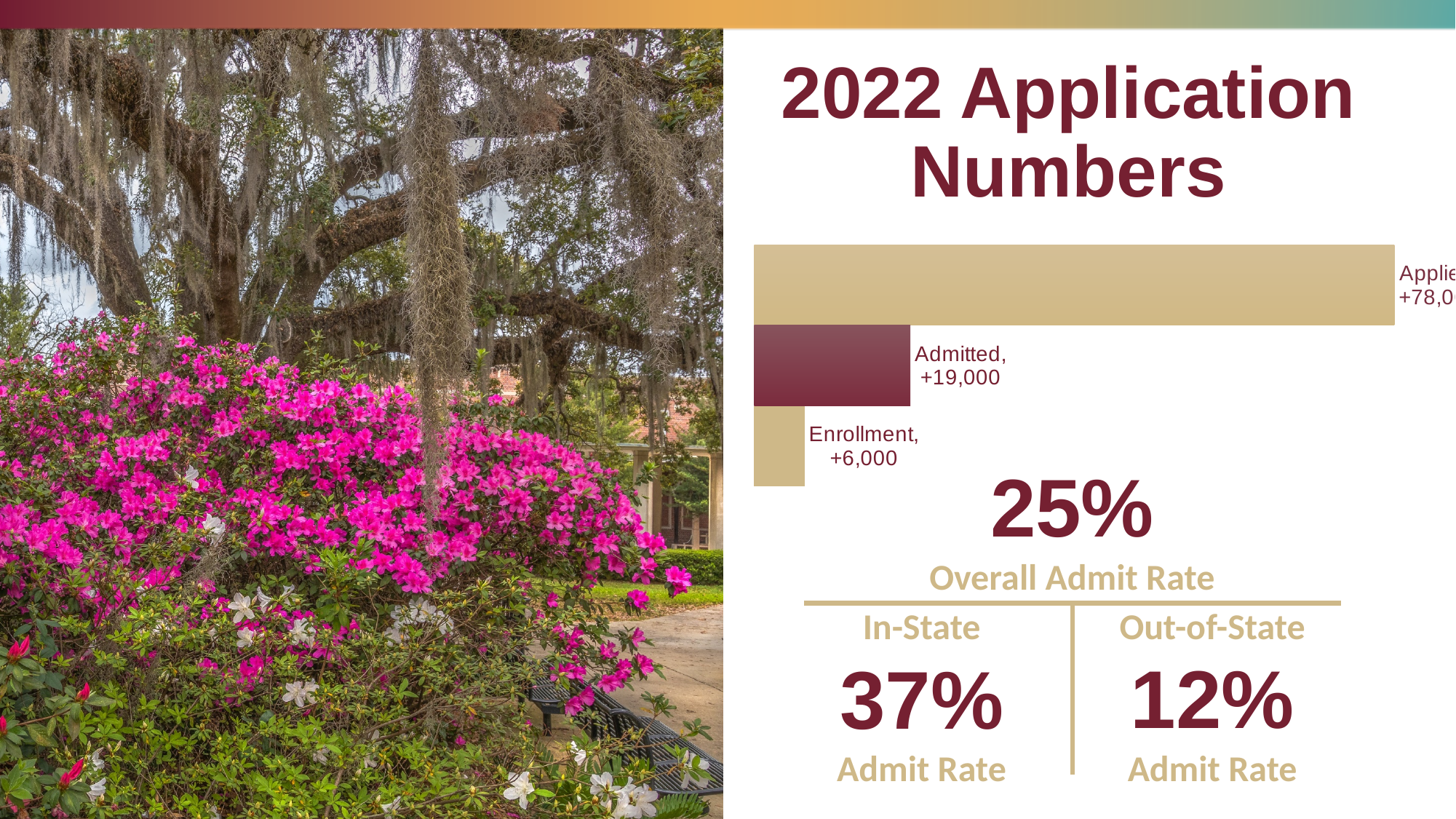
What value is labelled for Enrollment? +6,000 What kind of chart is shown on the slide? Bar chart Which is larger, Admitted or Enrollment? Admitted What colour is the Admitted bar? Dark red Which category has the shortest bar? Enrollment How many bars does the chart show? 3 What is the title of the slide containing the chart? 2022 Application Numbers What value is labelled for Admitted? +19,000